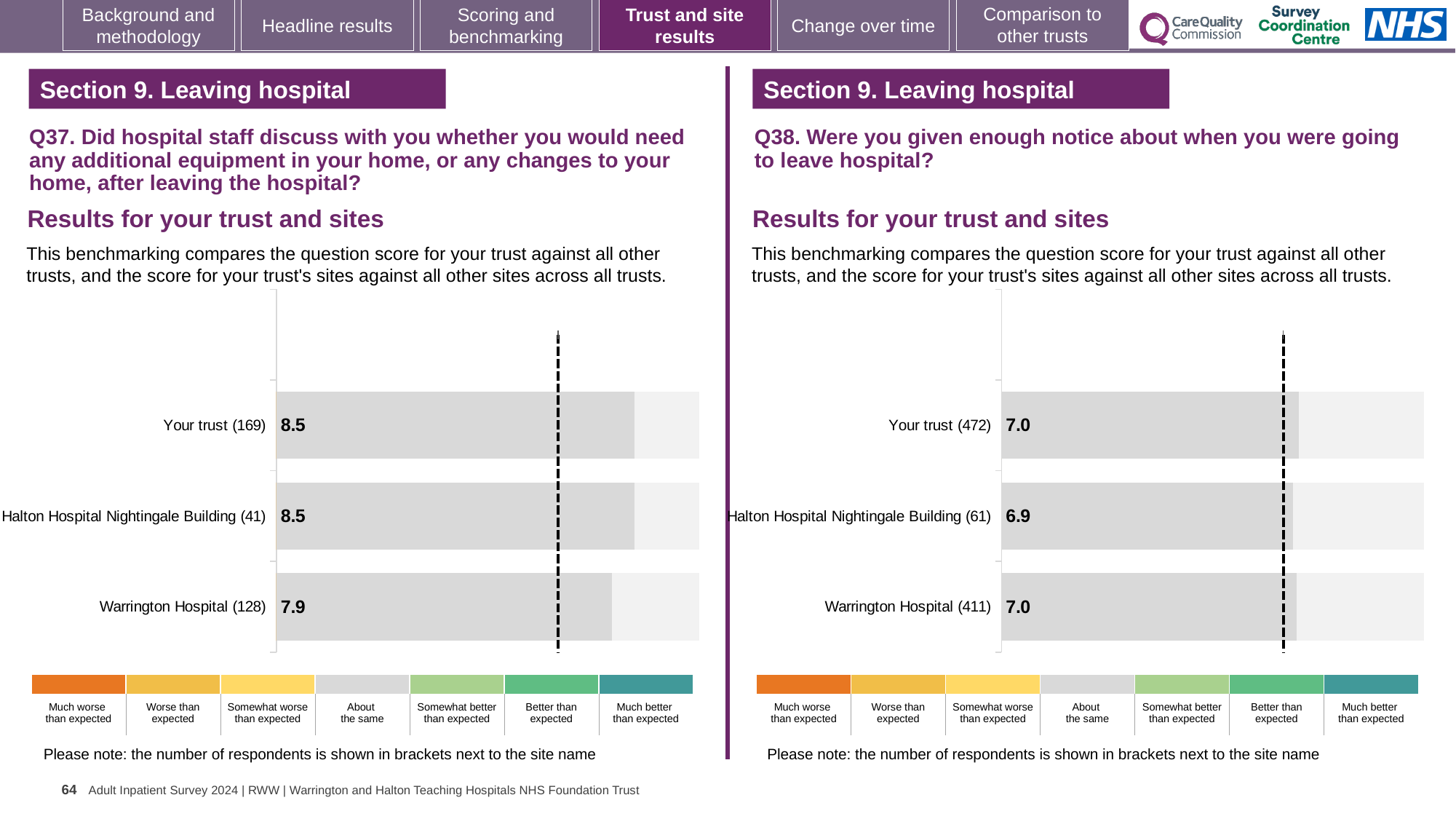
In the Q37 chart on the left, what is the score for Your trust? 8.5 In the Q38 chart on the right, what is the score for Warrington Hospital? 7.0 How many bars are plotted in the Q38 chart on the right? 3 In the Q37 chart on the left, what is the difference between the score for Your trust and the score for Warrington Hospital? 0.6 In the Q38 chart on the right, what is the score for Your trust? 7.0 In the Q37 chart on the left, what is the score for Warrington Hospital? 7.9 In the Q37 chart on the left, how many respondents are shown in brackets for Warrington Hospital? 128 In the Q37 chart on the left, which site has the lowest score? Warrington Hospital In the Q38 chart on the right, what is the score for Halton Hospital Nightingale Building? 6.9 In the Q37 chart on the left, what is the score for Halton Hospital Nightingale Building? 8.5 What type of chart is used in the Q37 chart on the left? Bar chart In the Q38 chart on the right, what is the difference between the score for Warrington Hospital and the score for Halton Hospital Nightingale Building? 0.1